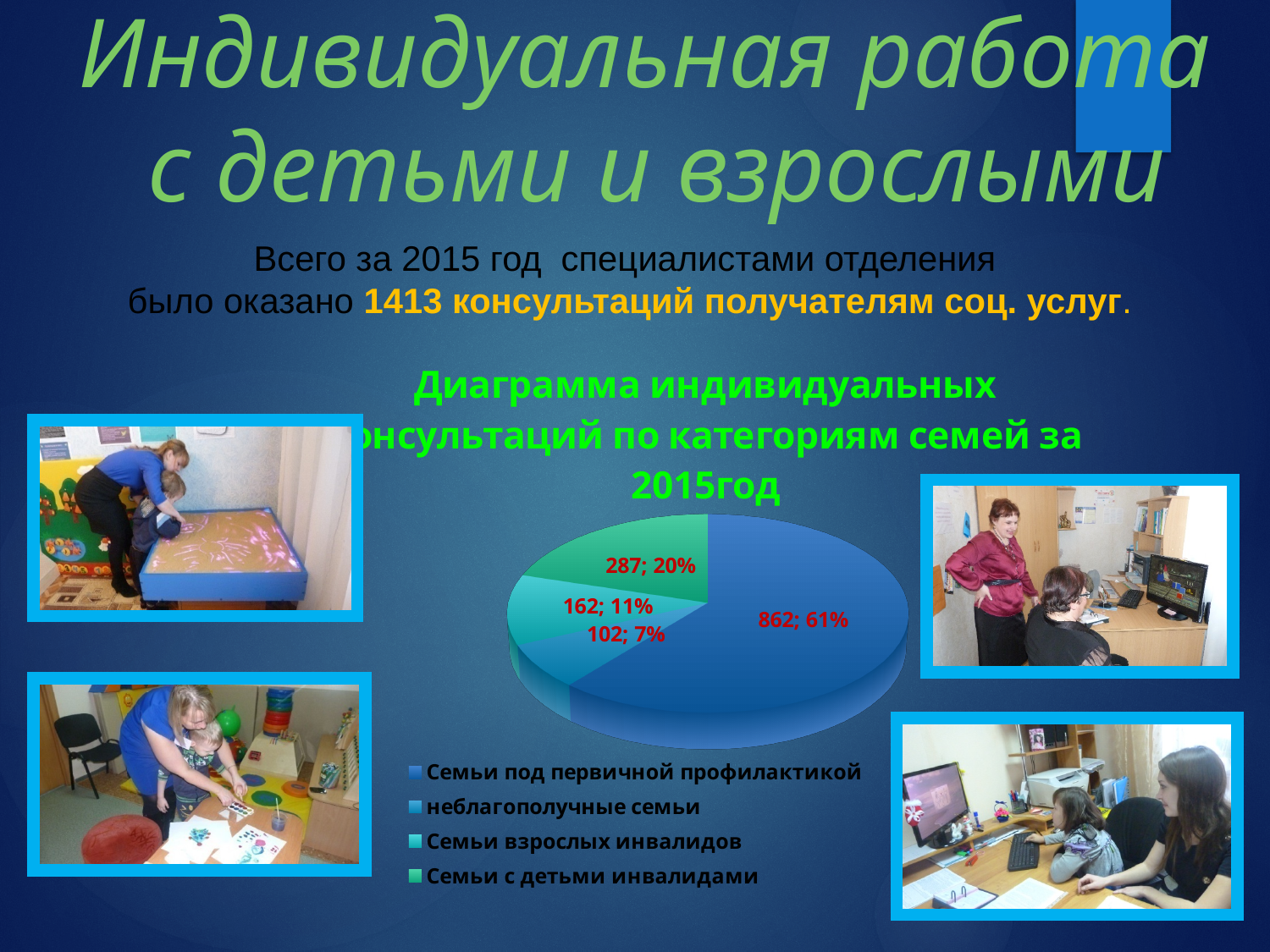
What is the difference between the values for 'Семьи с детьми инвалидами' and 'Семьи взрослых инвалидов'? 125 Which category has the smallest slice in the pie chart? неблагополучные семьи What kind of chart is shown on the slide? Pie chart What value is shown for the category 'Семьи под первичной профилактикой'? 862 What share of the pie does 'Семьи взрослых инвалидов' take? 11% What is the title of the chart? Диаграмма индивидуальных консультаций по категориям семей за 2015год Which is larger: the value for 'Семьи взрослых инвалидов' or for 'неблагополучные семьи'? Семьи взрослых инвалидов What share of the pie does 'Семьи под первичной профилактикой' take? 61% How many slices does the pie chart have? 4 How many categories does the legend of the pie chart list? 4 What value is shown for 'Семьи с детьми инвалидами'? 287 Which category has the largest slice in the pie chart? Семьи под первичной профилактикой